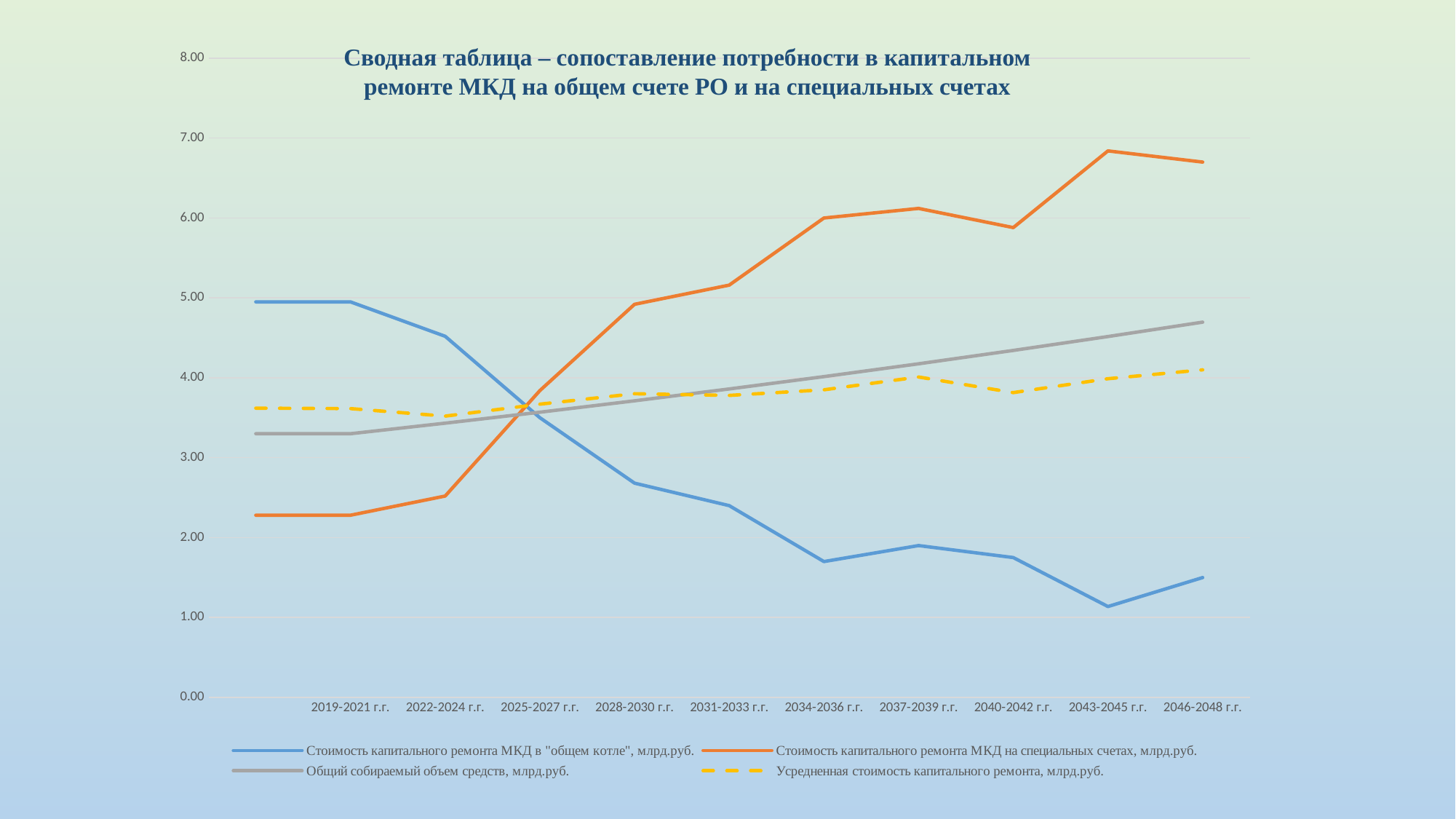
Is the value of "Стоимость капитального ремонта МКД на специальных счетах" for 2046-2048 г.г. greater or less than 6.00? greater Does the "Общий собираемый объем средств" line rise or fall from left to right along the x axis? rise For 2046-2048 г.г., which is larger: the value for "общем котле" or the value for "специальных счетах"? специальных счетах In which period does "Стоимость капитального ремонта МКД в "общем котле"" reach its lowest value? 2043-2045 г.г. How many series does the legend list? 4 Which series is drawn as a dashed line? Усредненная стоимость капитального ремонта, млрд.руб. Is the value of "Стоимость капитального ремонта МКД на специальных счетах" for 2022-2024 г.г. greater or less than 3.00? less In which period does "Стоимость капитального ремонта МКД на специальных счетах" reach its highest value? 2043-2045 г.г. For 2019-2021 г.г., which is larger: the value for "общем котле" or the value for "специальных счетах"? общем котле What kind of chart is shown on the slide? Line chart Is the value of "Общий собираемый объем средств" for 2046-2048 г.г. greater or less than 4.00? greater